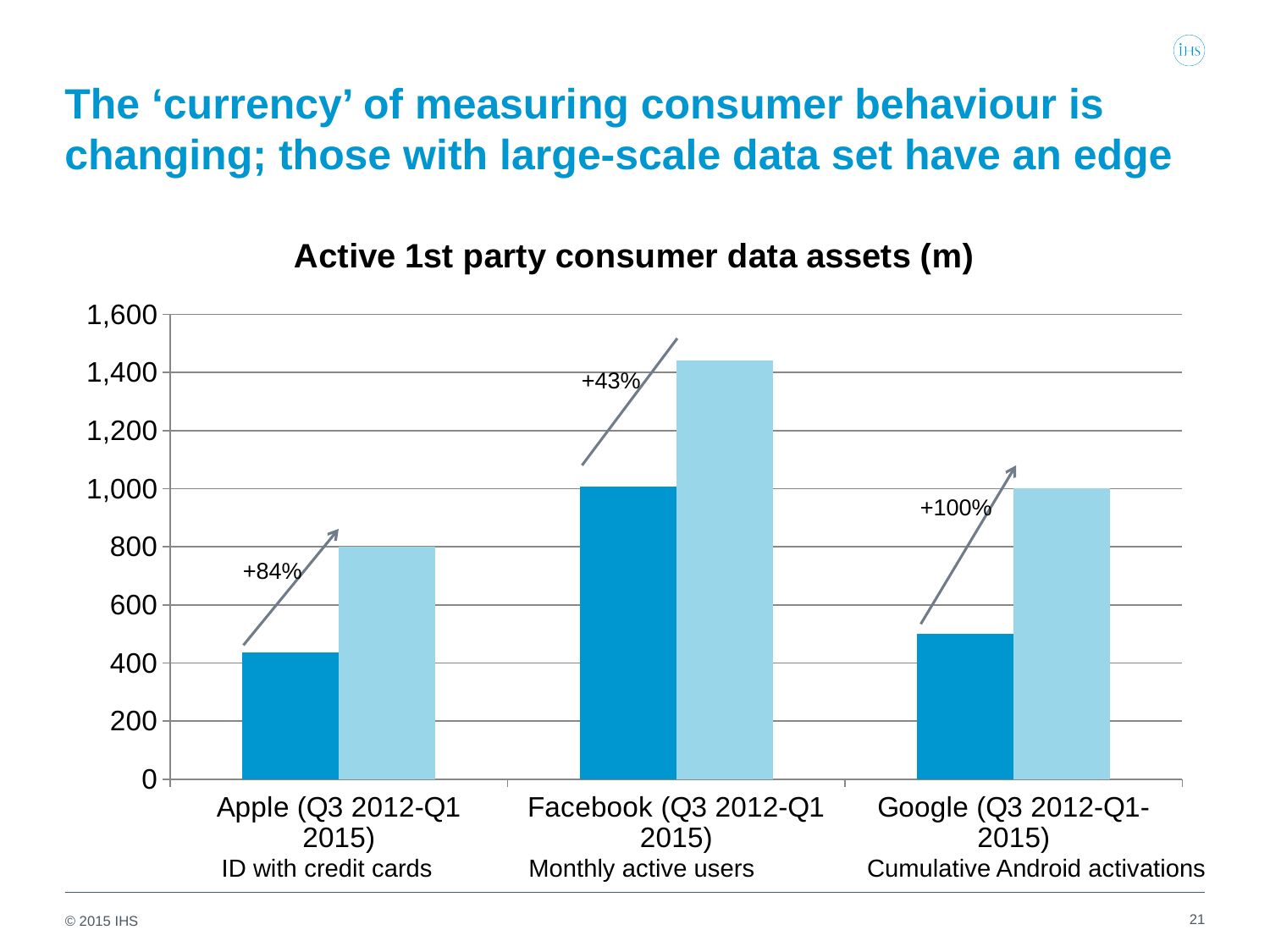
What growth percentage is annotated for Facebook (Q3 2012-Q1 2015)? +43% What is the title of the chart? Active 1st party consumer data assets (m) What growth percentage is annotated for Apple (Q3 2012-Q1 2015)? +84% Which is larger: the light blue (later) bar for Apple or the dark blue (earlier) bar for Facebook? the dark blue bar for Facebook Is the value of the light blue (later) bar for Facebook greater or less than 1,400? greater Which company has the largest annotated growth percentage? Google What type of chart is shown on the slide? bar chart What growth percentage is annotated for Google (Q3 2012-Q1 2015)? +100% How many companies (categories) are shown on the x axis of the chart? 3 Which company has the smallest annotated growth percentage? Facebook Is the value of the dark blue (earlier) bar for Apple greater or less than 600? less Which company has the tallest bar in the chart? Facebook